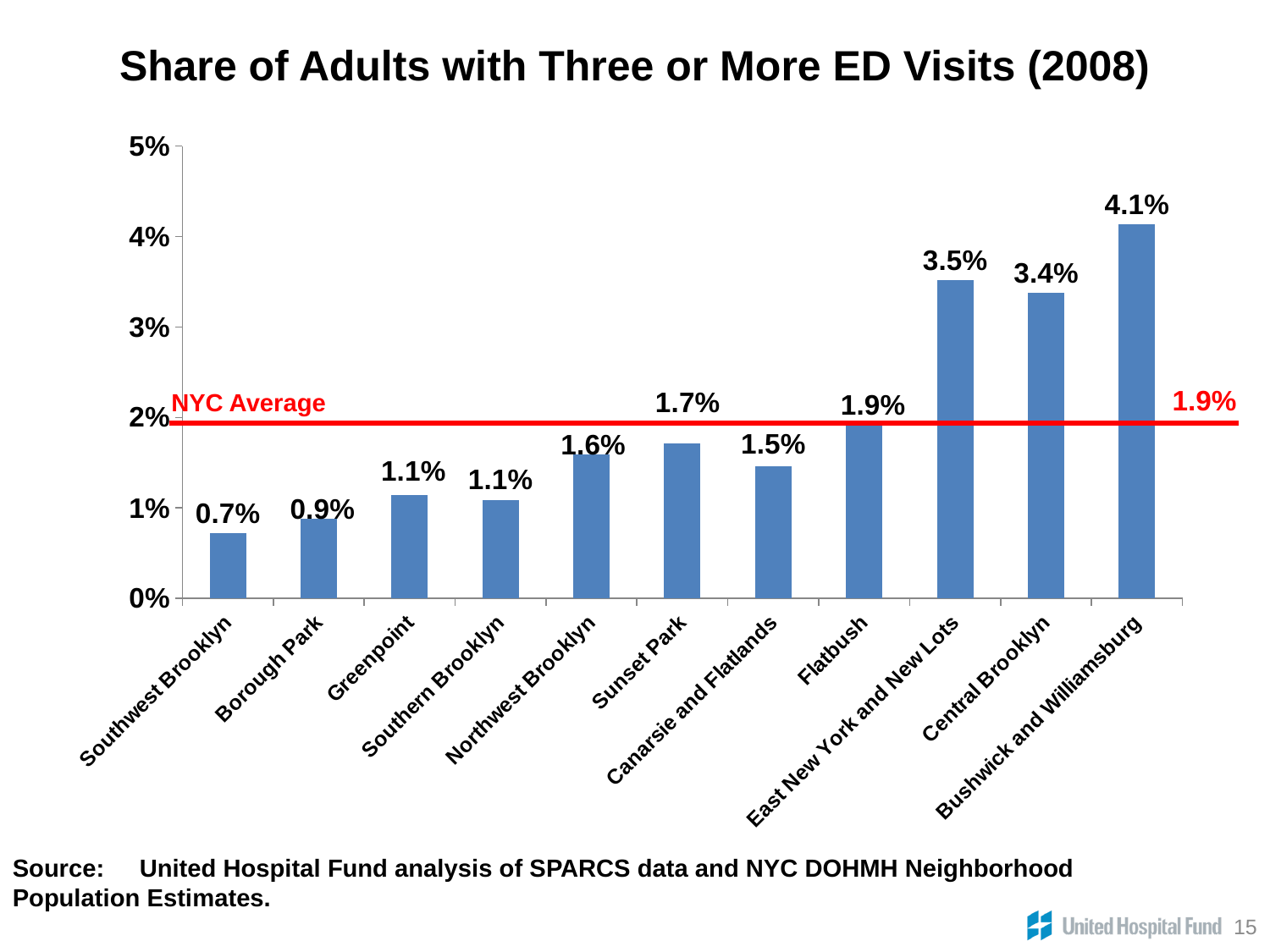
What is the difference between the values for Bushwick and Williamsburg and Southwest Brooklyn? 3.4% Which neighborhood has the lowest share of adults with three or more ED visits? Southwest Brooklyn Is the value for Flatbush greater or less than 3%? less What is the share of adults with three or more ED visits in Bushwick and Williamsburg? 4.1% Do the values generally rise or fall from left to right across the neighborhoods? Rise What is the value shown for Sunset Park? 1.7% Which neighborhood has the highest share of adults with three or more ED visits? Bushwick and Williamsburg What value does the red NYC Average line represent? 1.9% Which has a larger value, East New York and New Lots or Central Brooklyn? East New York and New Lots How many neighborhoods are shown on the chart? 11 What kind of chart is shown on the slide? Bar chart What is the value shown for Southwest Brooklyn? 0.7%